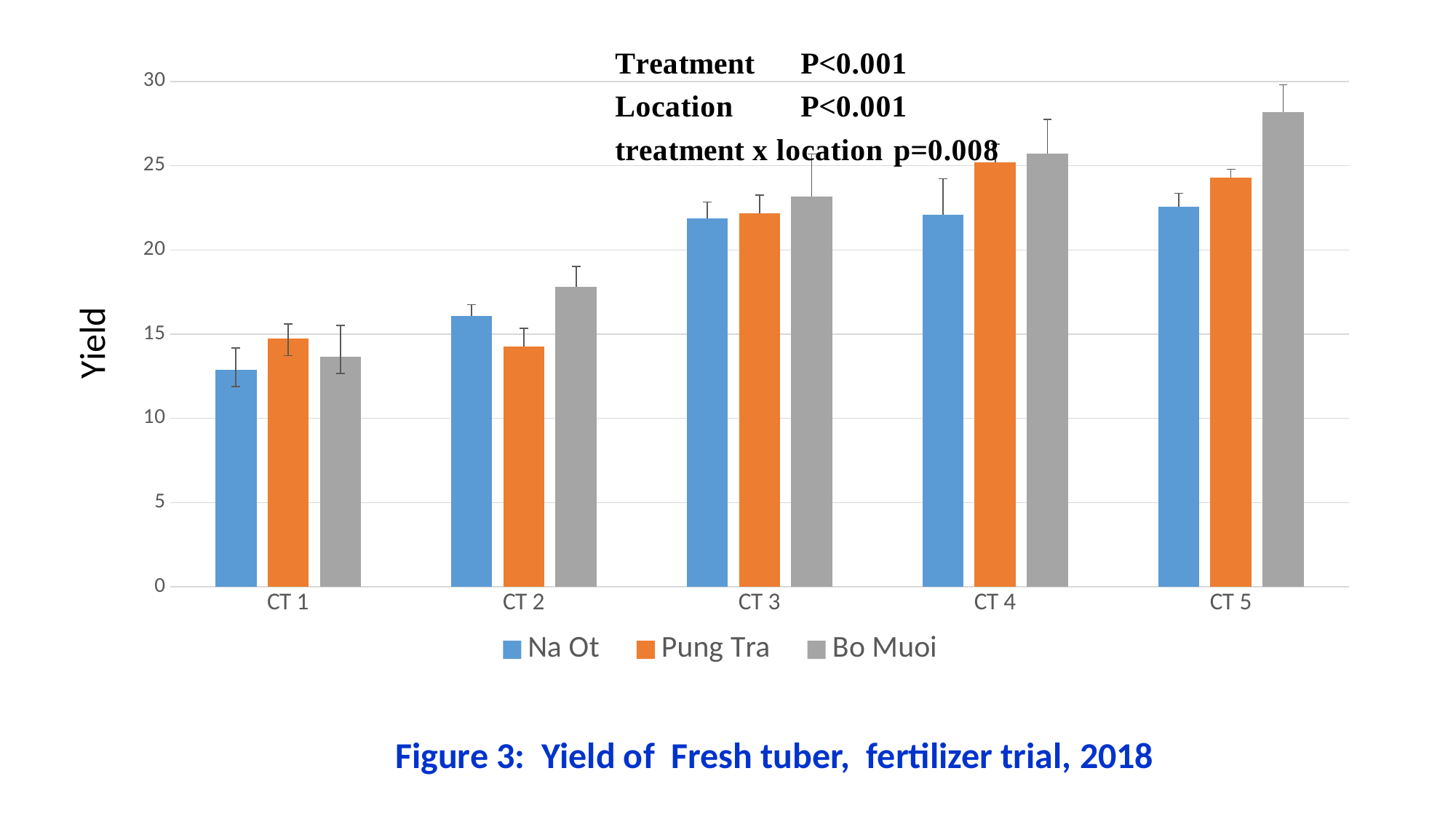
Is the Bo Muoi value for CT 5 greater or less than 25? greater For CT 5, which is larger: the Bo Muoi value or the Na Ot value? Bo Muoi How many series does the legend list? 3 Is the Na Ot value for CT 1 greater or less than 15? less What is the label on the y axis? Yield For which treatment is the Na Ot bar lowest? CT 1 How many treatment categories are shown on the x axis? 5 What kind of chart is shown on the slide? bar chart Do the Bo Muoi values rise or fall from CT 1 to CT 5? rise Is the Pung Tra value for CT 4 greater or less than 20? greater For which treatment is the Bo Muoi bar highest? CT 5 For CT 2, which is larger: the Na Ot value or the Pung Tra value? Na Ot